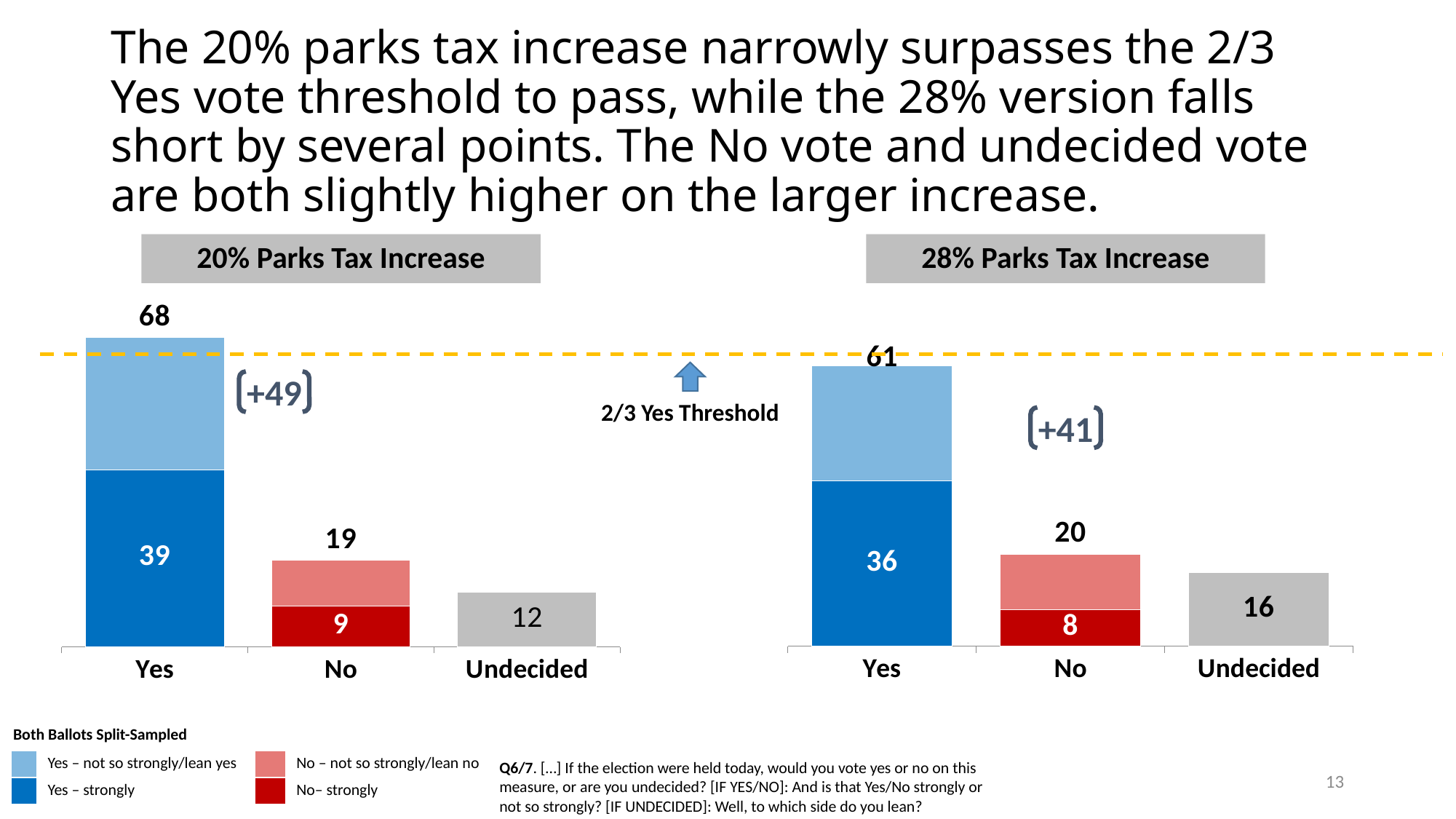
In the 28% Parks Tax Increase chart, which category has the highest total? Yes In the 28% Parks Tax Increase chart, what is the total Yes vote? 61 Is the Undecided value larger in the 20% Parks Tax Increase chart or the 28% Parks Tax Increase chart? 28% Parks Tax Increase In the 28% Parks Tax Increase chart, what is the value for No – strongly? 8 What type of chart is the 28% Parks Tax Increase chart? Stacked bar chart In the 20% Parks Tax Increase chart, which category has the lowest total? Undecided How many entries does the legend at the bottom of the slide list? 4 How many categories are shown on the x axis of the 20% Parks Tax Increase chart? 3 In the 20% Parks Tax Increase chart, what is the total Yes vote? 68 In the 28% Parks Tax Increase chart, what is the value for Undecided? 16 In the 20% Parks Tax Increase chart, what is the value for Yes – strongly? 39 What is the difference between the total Yes vote in the 20% Parks Tax Increase chart and the total Yes vote in the 28% Parks Tax Increase chart? 7